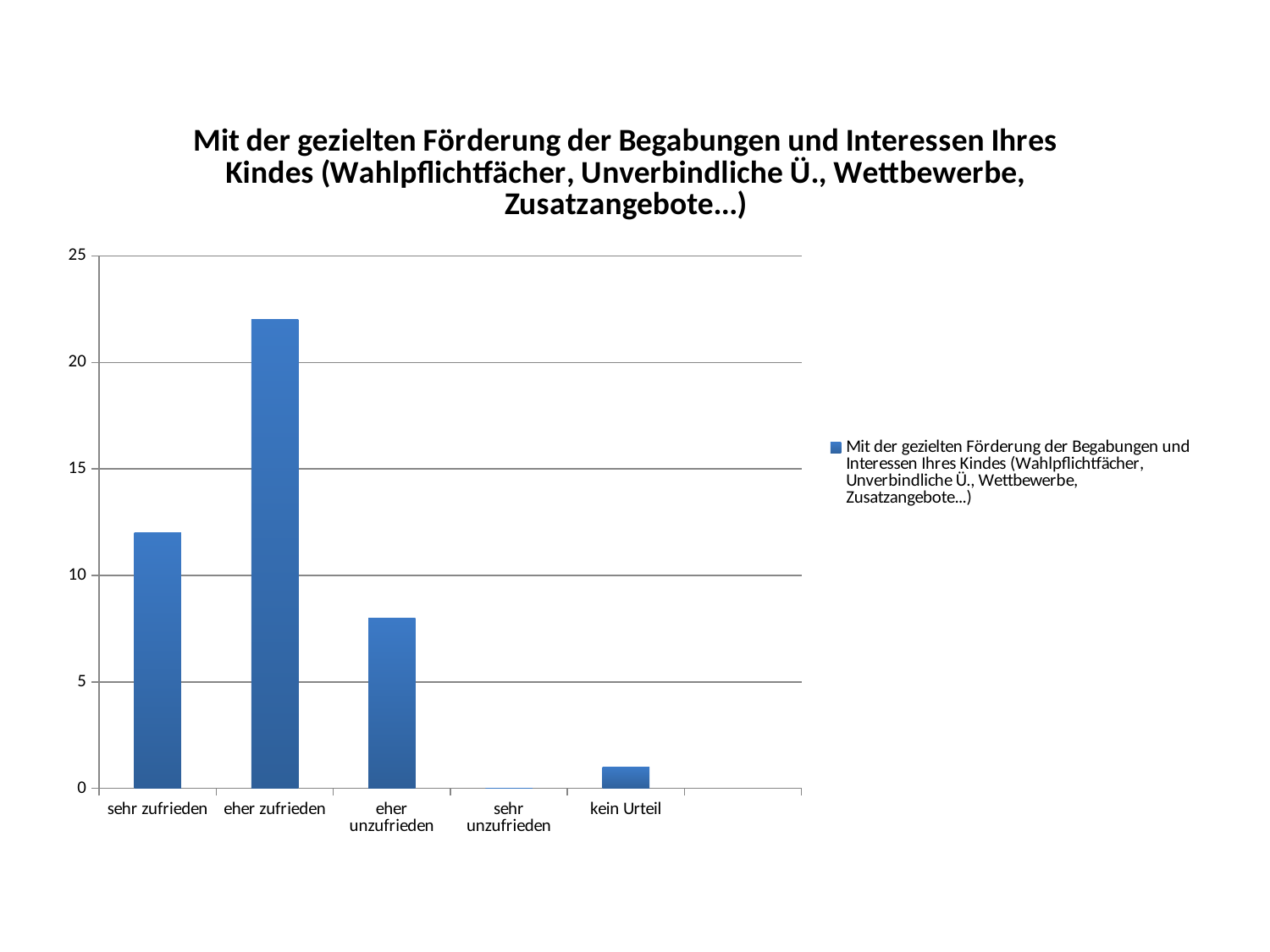
Which category has the highest value? eher zufrieden How many categories are shown on the x axis? 5 How many series does the legend list? 1 Is the value for kein Urteil greater or less than 5? less What kind of chart is shown on the slide? bar chart Is the value for eher unzufrieden greater or less than 10? less Is the value for sehr zufrieden greater or less than 10? greater What colour are the bars in the chart? blue Which is larger, the value for kein Urteil or the value for eher unzufrieden? eher unzufrieden Which category has the lowest value? sehr unzufrieden Which is larger, the value for sehr zufrieden or the value for eher unzufrieden? sehr zufrieden